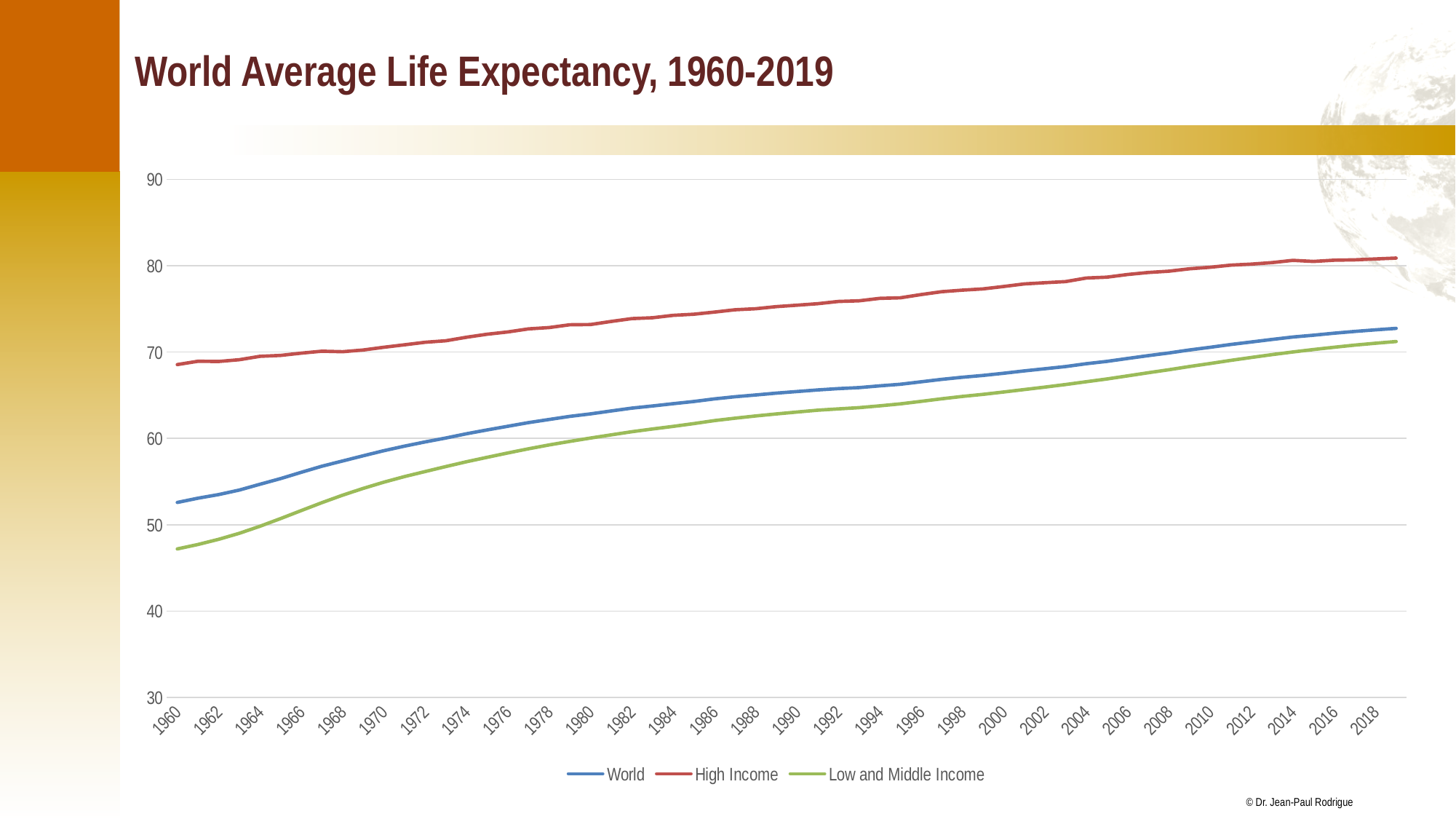
In 1990, which is larger: the value for World or the value for Low and Middle Income? World Is the value for High Income in 1960 greater or less than 70? less How many series does the legend list? 3 Which series is drawn in red? High Income Which series has the lowest value in 1960? Low and Middle Income What is the title of the chart? World Average Life Expectancy, 1960-2019 Is the value for Low and Middle Income in 1960 greater or less than 50? less What kind of chart is shown on the slide? line chart Is the value for World in 1960 greater or less than 50? greater Which series has the highest value in 2000? High Income Does the World series rise or fall from 1960 to 2018? rise